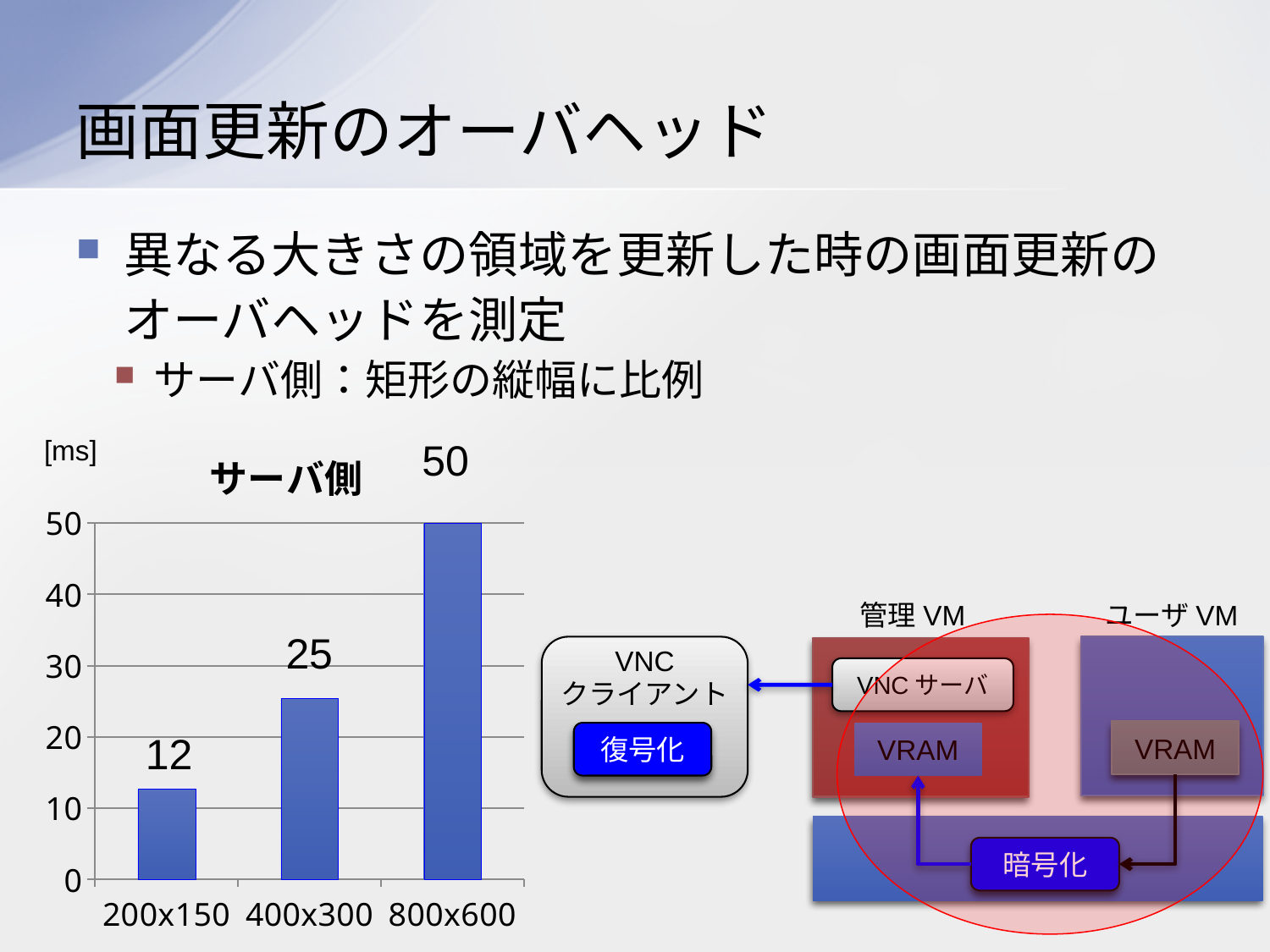
Which category has the highest value in the サーバ側 chart? 800x600 What is the value for 200x150 in the サーバ側 chart? 12 How many categories are shown in the サーバ側 chart? 3 What is the value for 800x600 in the サーバ側 chart? 50 What is the difference between the values for 800x600 and 400x300 in the サーバ側 chart? 25 What kind of chart is the サーバ側 chart? bar chart Which category has the lowest value in the サーバ側 chart? 200x150 What is the value for 400x300 in the サーバ側 chart? 25 What is the difference between the values for 400x300 and 200x150 in the サーバ側 chart? 13 Which is larger in the サーバ側 chart, the value for 400x300 or the value for 200x150? 400x300 Is the value for 800x600 in the サーバ側 chart greater or less than 40? greater What unit is shown on the y axis of the サーバ側 chart? [ms]